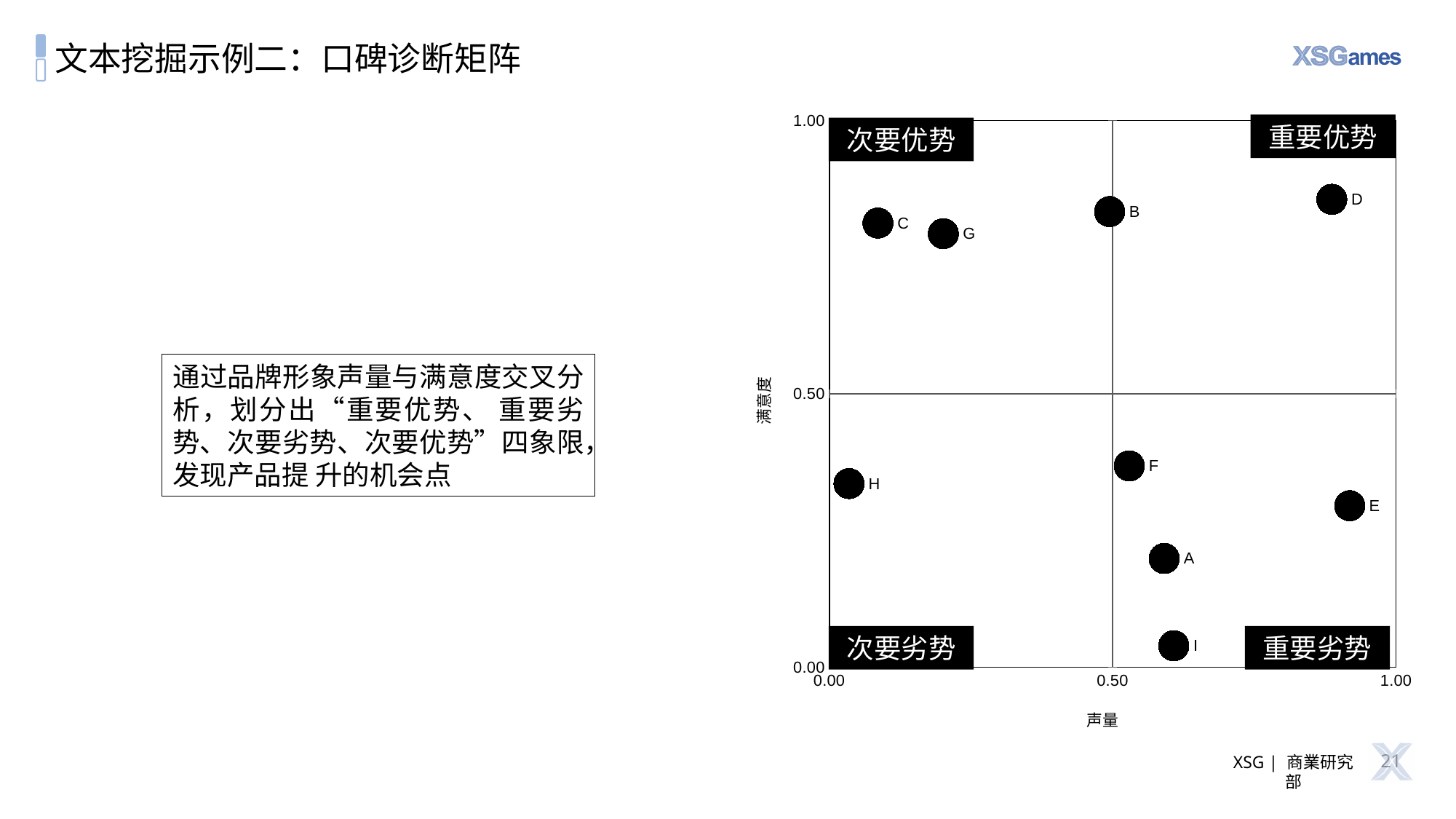
What kind of chart is shown on the slide? scatter chart Which point has the lowest 满意度 value? I Is the 声量 value for point H greater or less than 0.50? less How many labelled points are plotted on the chart? 9 Which point has the lowest 声量 value? H Is the 声量 value for point E greater or less than 0.50? greater Which point has the higher 满意度 value, A or F? F Is the 满意度 value for point D greater or less than 0.50? greater What is the label shown in the top-right quadrant of the chart? 重要优势 Which point has the higher 声量 value, B or C? B What is the label of the horizontal axis of the chart? 声量